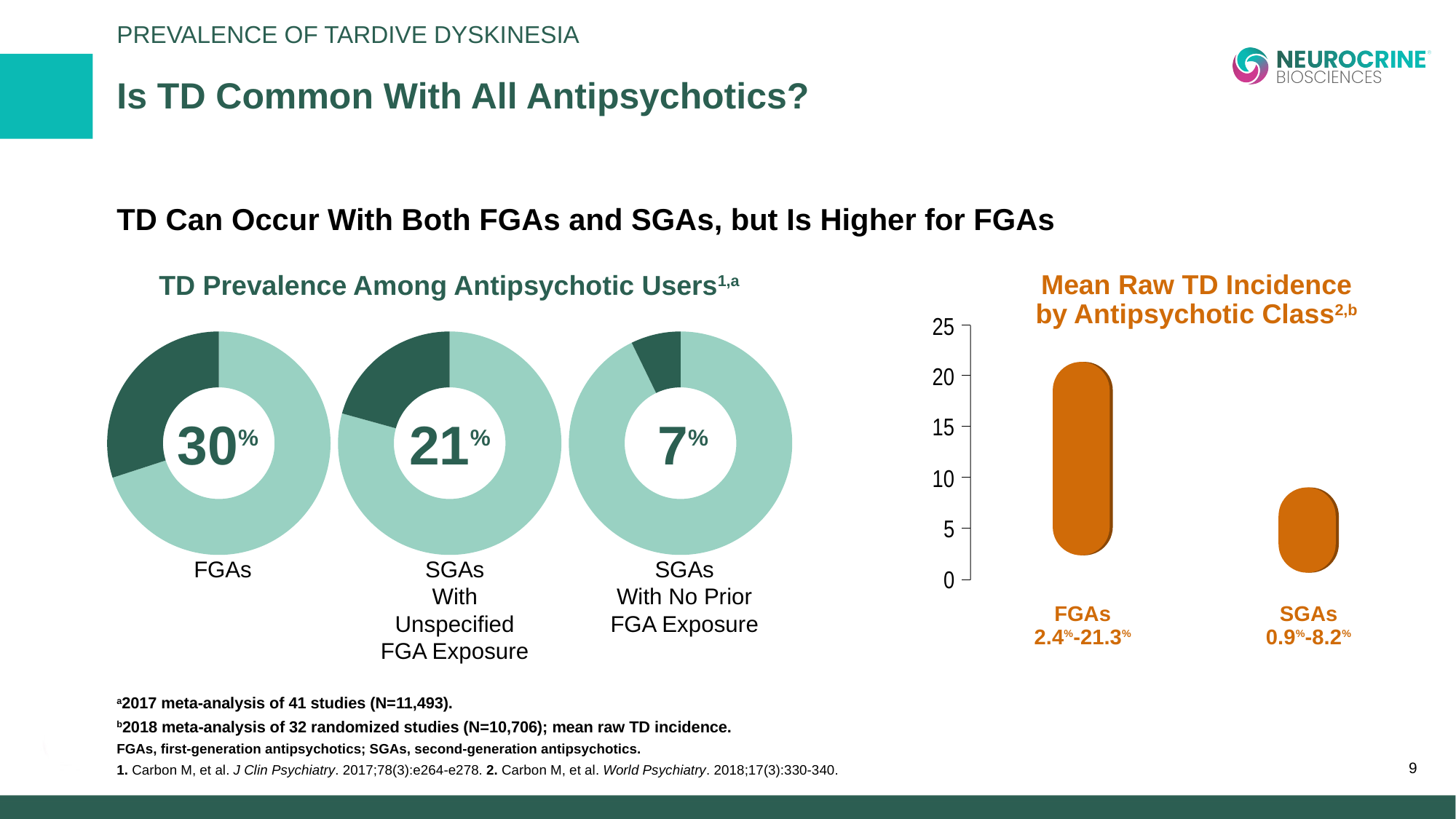
In the 'TD Prevalence Among Antipsychotic Users' chart, what is the TD prevalence for SGAs with no prior FGA exposure? 7% In the 'Mean Raw TD Incidence by Antipsychotic Class' chart, is the top of the FGAs bar greater or less than 20? greater In the 'TD Prevalence Among Antipsychotic Users' chart, which is larger: the prevalence for FGAs or for SGAs with unspecified FGA exposure? FGAs In the 'Mean Raw TD Incidence by Antipsychotic Class' chart, what is the incidence range shown for SGAs? 0.9%-8.2% In the 'Mean Raw TD Incidence by Antipsychotic Class' chart, what is the incidence range shown for FGAs? 2.4%-21.3% In the 'TD Prevalence Among Antipsychotic Users' chart, what is the TD prevalence for SGAs with unspecified FGA exposure? 21% How many donut charts are shown under 'TD Prevalence Among Antipsychotic Users'? 3 In the 'TD Prevalence Among Antipsychotic Users' chart, which group has the lowest TD prevalence? SGAs With No Prior FGA Exposure In the 'TD Prevalence Among Antipsychotic Users' chart, which group has the highest TD prevalence? FGAs In the 'TD Prevalence Among Antipsychotic Users' chart, what is the difference in TD prevalence between FGAs and SGAs with no prior FGA exposure? 23 percentage points In the 'TD Prevalence Among Antipsychotic Users' chart, what is the TD prevalence for FGAs? 30% What kind of chart is used for 'TD Prevalence Among Antipsychotic Users'? Donut (pie) chart